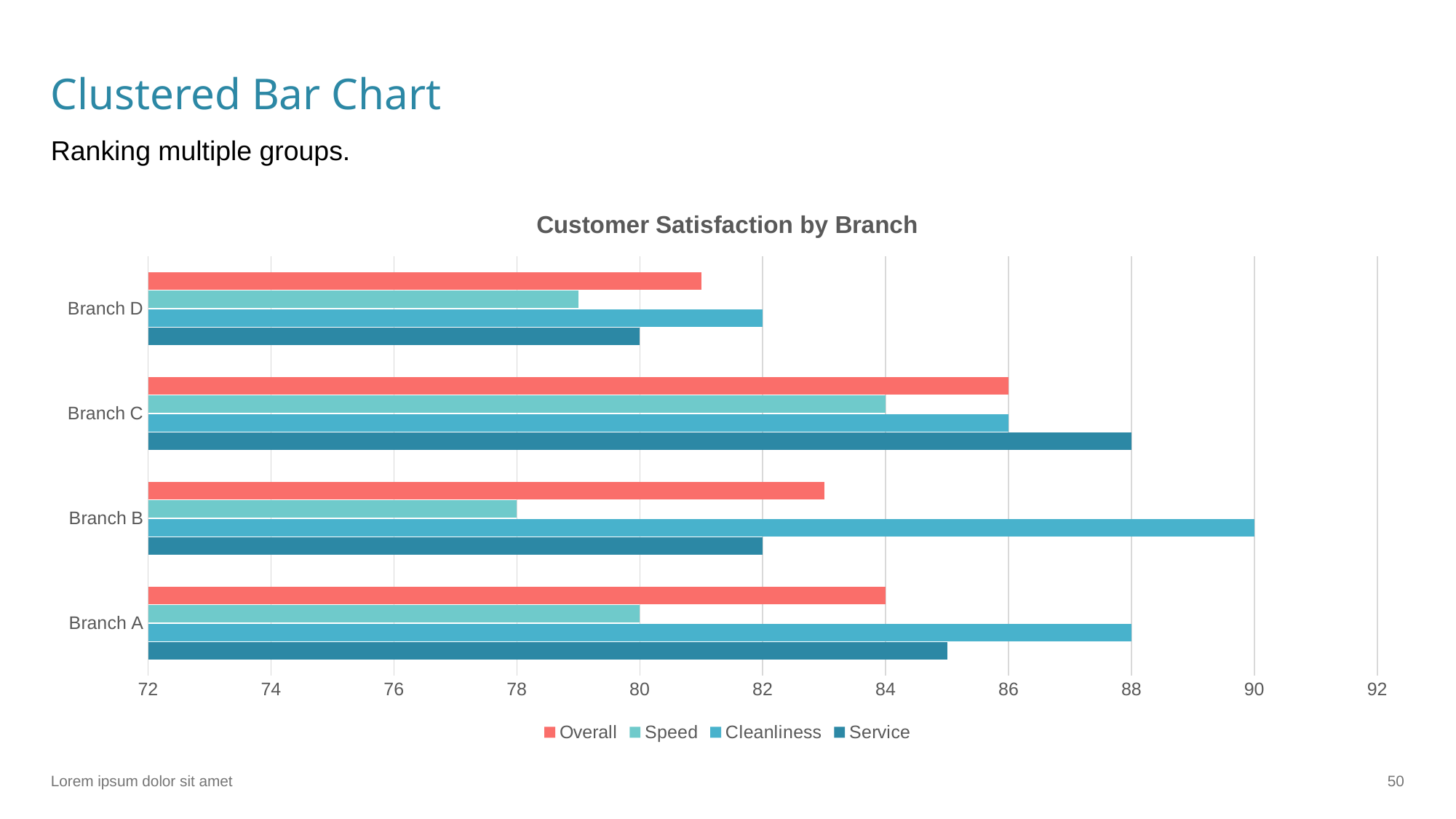
What is the Service value for Branch C? 88 Is the Service value for Branch A greater or less than 84? greater Which is larger, the Speed value for Branch C or the Speed value for Branch B? Branch C What is the Speed value for Branch A? 80 Which branch has the highest Cleanliness value? Branch B What type of chart is shown on the slide? bar chart How many branches are shown on the chart? 4 What is the Cleanliness value for Branch B? 90 What is the title of the chart? Customer Satisfaction by Branch Is the Overall value for Branch D greater or less than 82? less Which branch has the lowest Service value? Branch D How many series does the legend list? 4